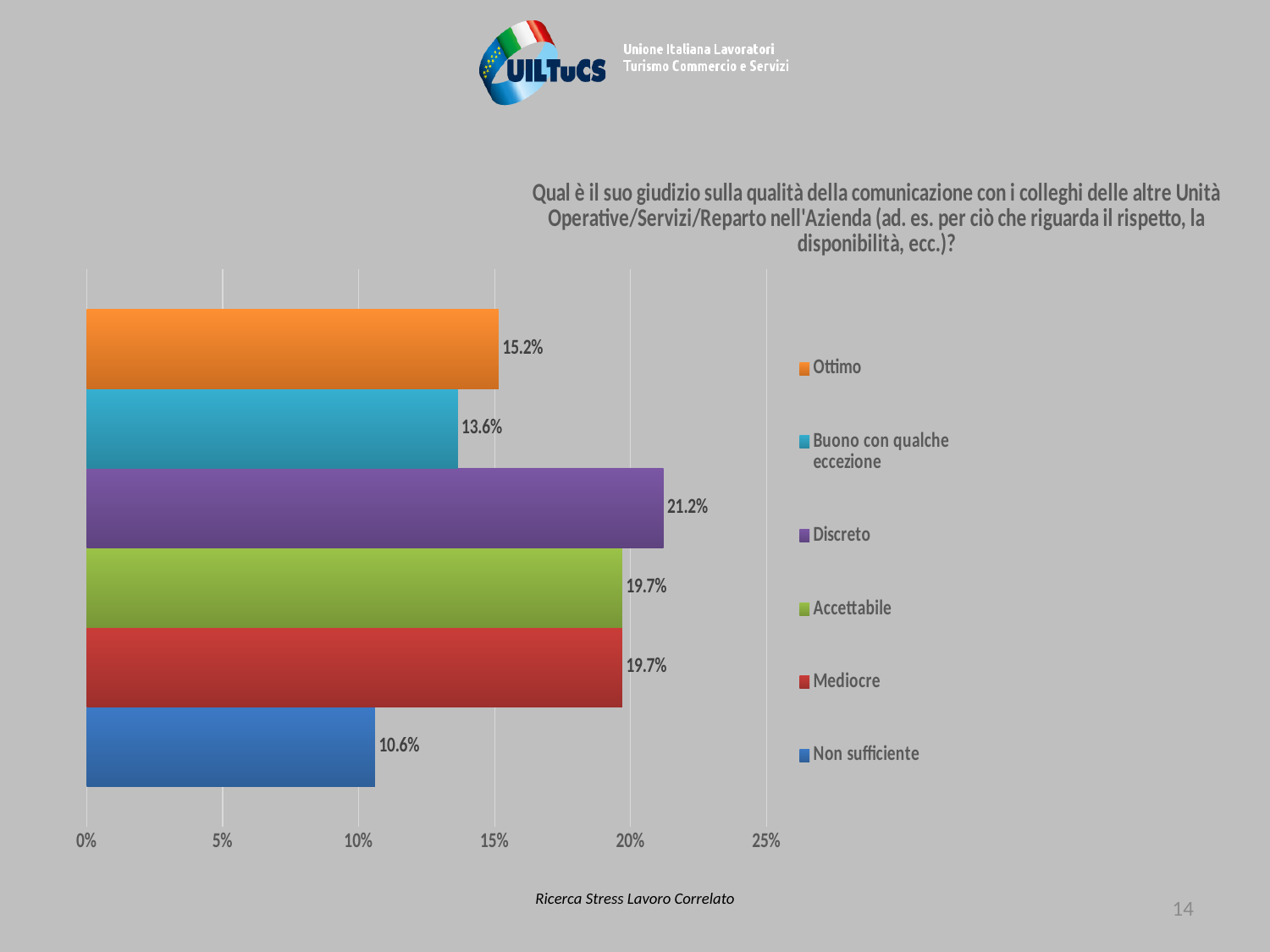
Is the value for Discreto greater or less than 20%? greater What is the value for Ottimo? 15.2% Which is larger, the value for Ottimo or the value for Buono con qualche eccezione? Ottimo What is the value for Non sufficiente? 10.6% What is the difference between the values for Discreto and Non sufficiente? 10.6% What is the difference between the values for Ottimo and Buono con qualche eccezione? 1.6% What is the value for Buono con qualche eccezione? 13.6% How many categories are shown in the chart? 6 Which category has the lowest value? Non sufficiente What is the value for Discreto? 21.2% Which category has the highest value? Discreto What kind of chart is shown on the slide? bar chart